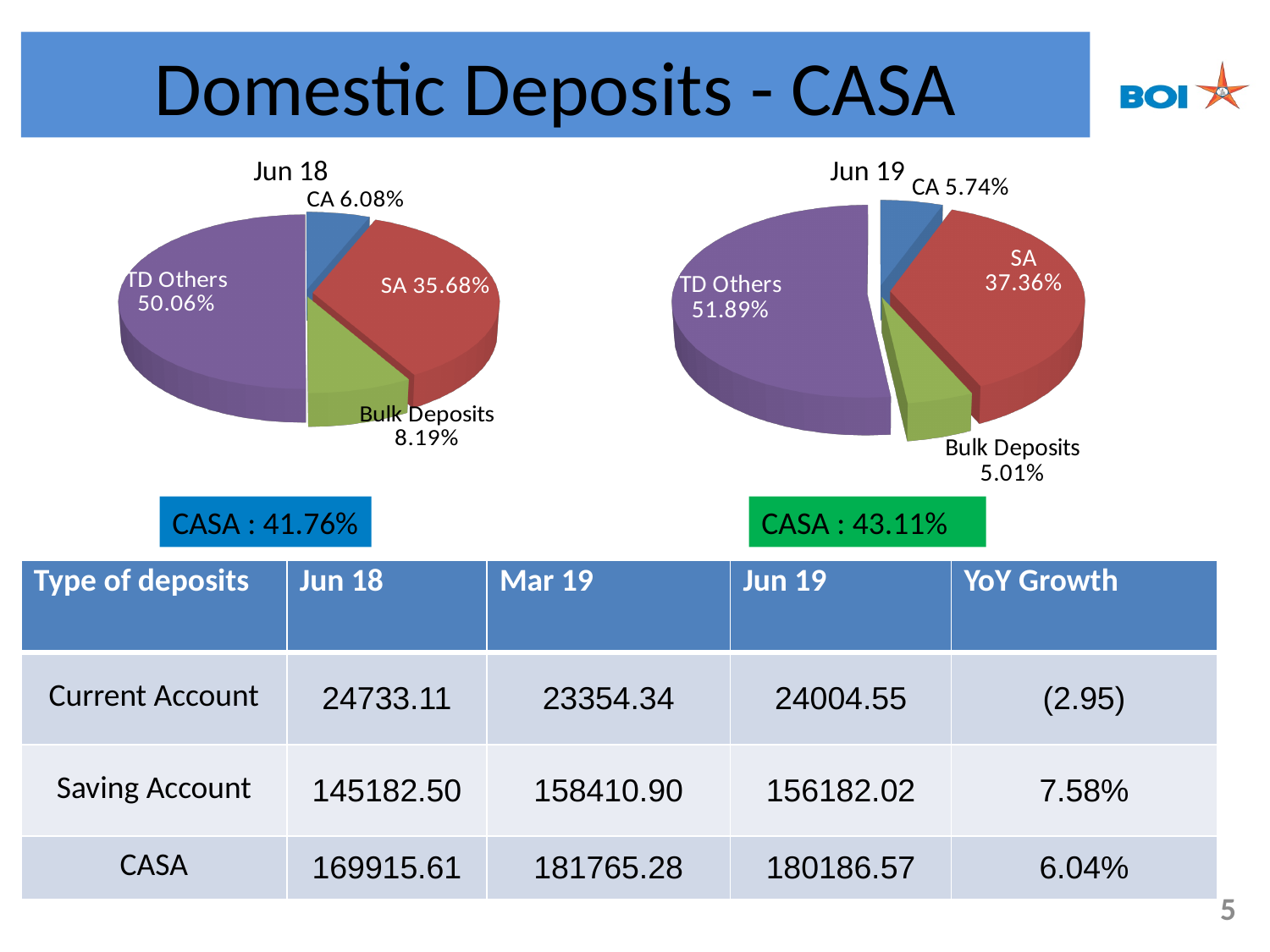
In the Jun 18 pie chart, which category has the largest share? TD Others In the Jun 18 pie chart, what share do Bulk Deposits have? 8.19% What colour is the TD Others slice in the Jun 18 pie chart? Purple In the Jun 19 pie chart, which category has the smallest share? Bulk Deposits In the Jun 19 pie chart, what share does SA have? 37.36% What type of chart is used for Jun 18? Pie chart Is the SA share larger in the Jun 18 pie chart or the Jun 19 pie chart? Jun 19 In the Jun 19 pie chart, what share does CA have? 5.74% In the Jun 18 pie chart, which category has the smallest share? CA In the Jun 19 pie chart, what is the difference between the TD Others share and the SA share? 14.53% How many slices does the Jun 19 pie chart have? 4 In the Jun 18 pie chart, what is the difference between the Bulk Deposits share and the CA share? 2.11%